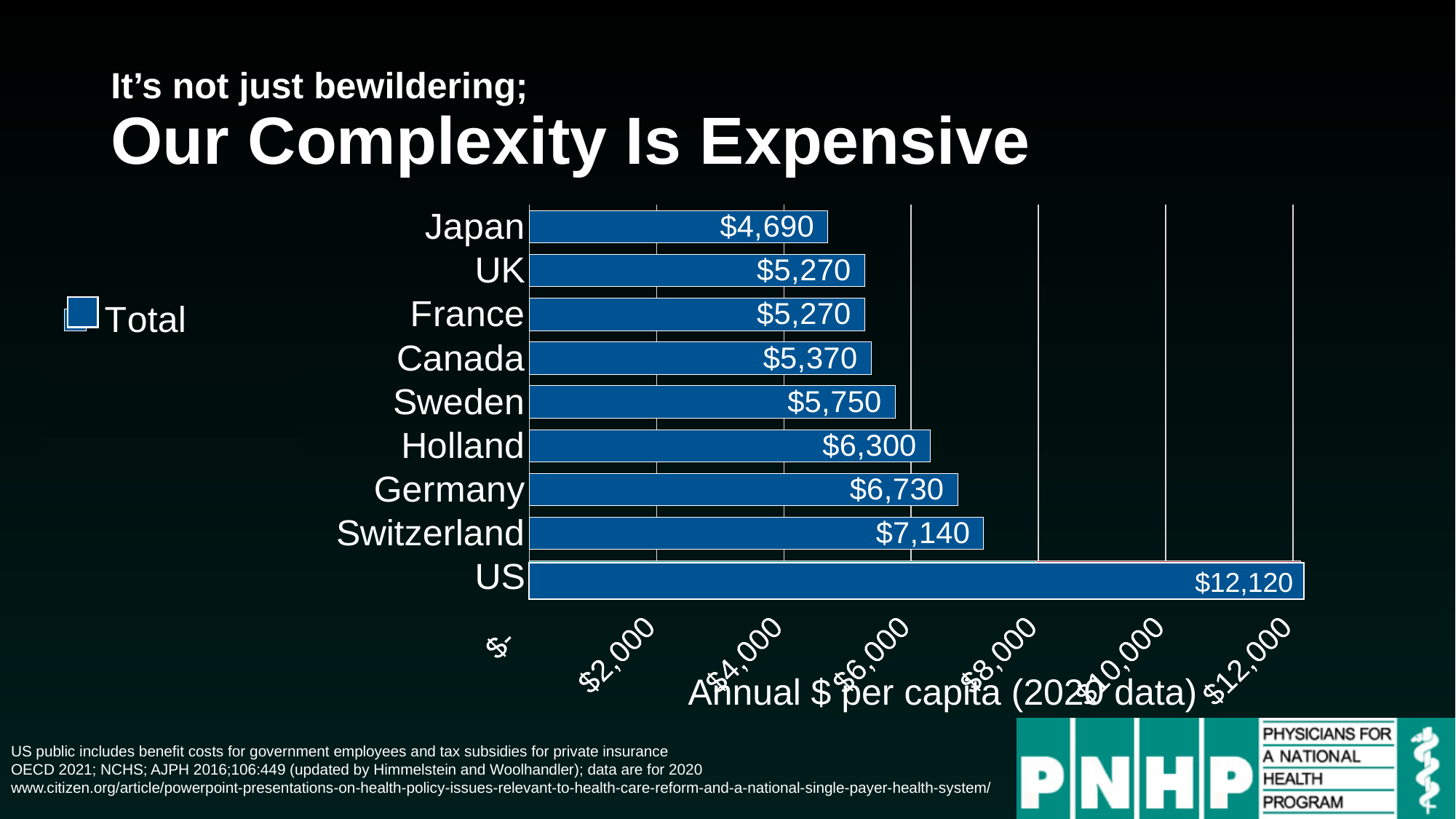
What is the difference between Germany's value and Holland's value? $430 Which country has the highest annual $ per capita? US What is the difference between the US value and the Switzerland value? $4,980 Which country has the lowest annual $ per capita? Japan What is the annual $ per capita value for the US? $12,120 What is the value shown for Canada? $5,370 How many countries are shown in the chart? 9 What is the x-axis title of the chart? Annual $ per capita (2020 data) What is the annual $ per capita value for Japan? $4,690 What is the value shown for Switzerland? $7,140 Which has a larger value, Sweden or Canada? Sweden What type of chart is shown on the slide? Bar chart